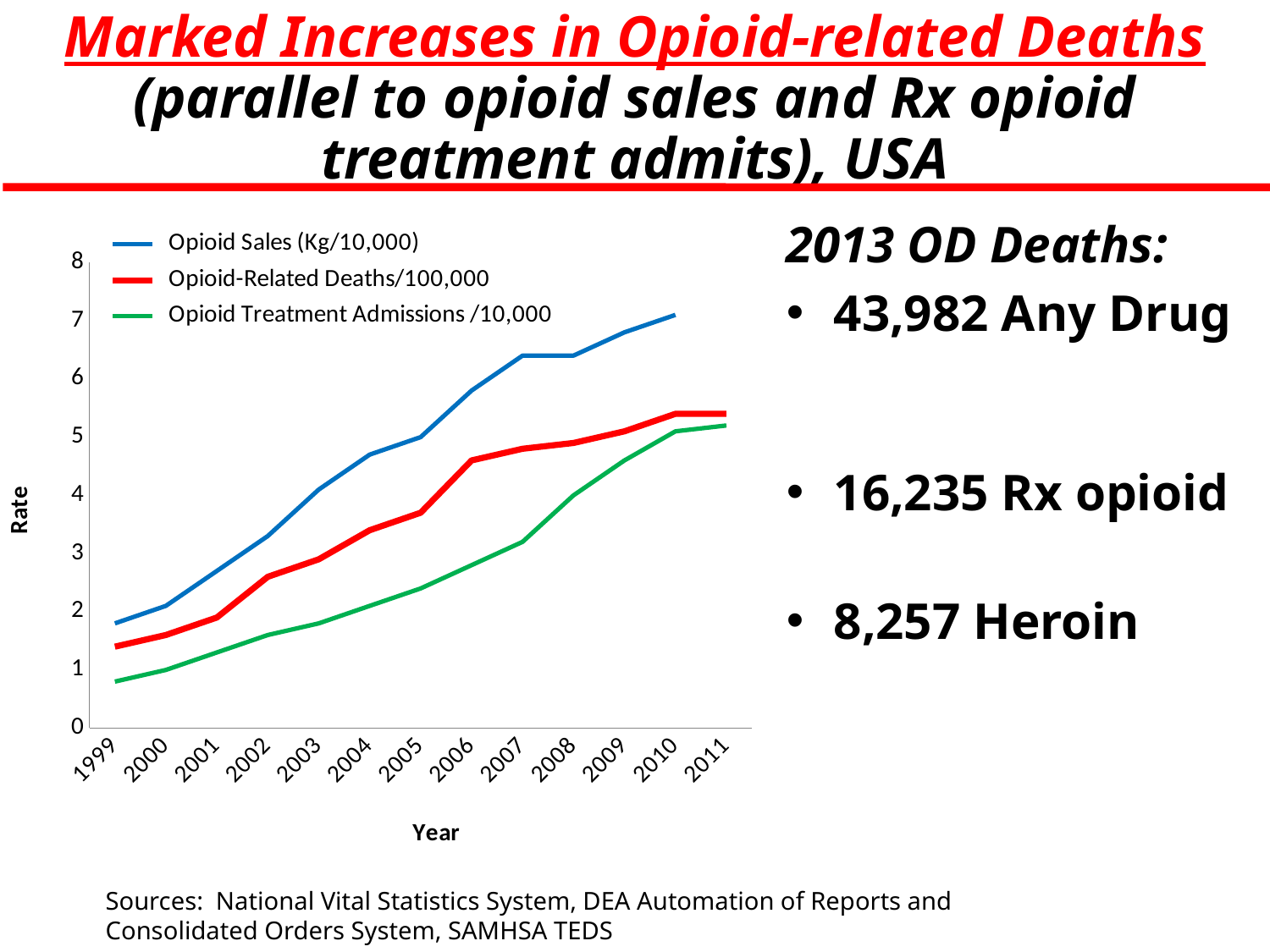
Is the value for Opioid-Related Deaths/100,000 in 2011 greater or less than 5? greater Is the value for Opioid Treatment Admissions /10,000 in 1999 greater or less than 1? less Do the Opioid-Related Deaths/100,000 values rise or fall from 1999 to 2011? Rise Which series has the highest value in 2010? Opioid Sales (Kg/10,000) Is the value for Opioid Sales (Kg/10,000) in 2010 greater or less than 6? greater What is the label on the chart's vertical axis? Rate In 2005, which is larger: Opioid Sales (Kg/10,000) or Opioid-Related Deaths/100,000? Opioid Sales (Kg/10,000) How many years are labelled along the x axis of the chart? 13 Which series has the lowest value in 1999? Opioid Treatment Admissions /10,000 How many series does the chart's legend list? 3 What kind of chart is shown on the slide? Line chart